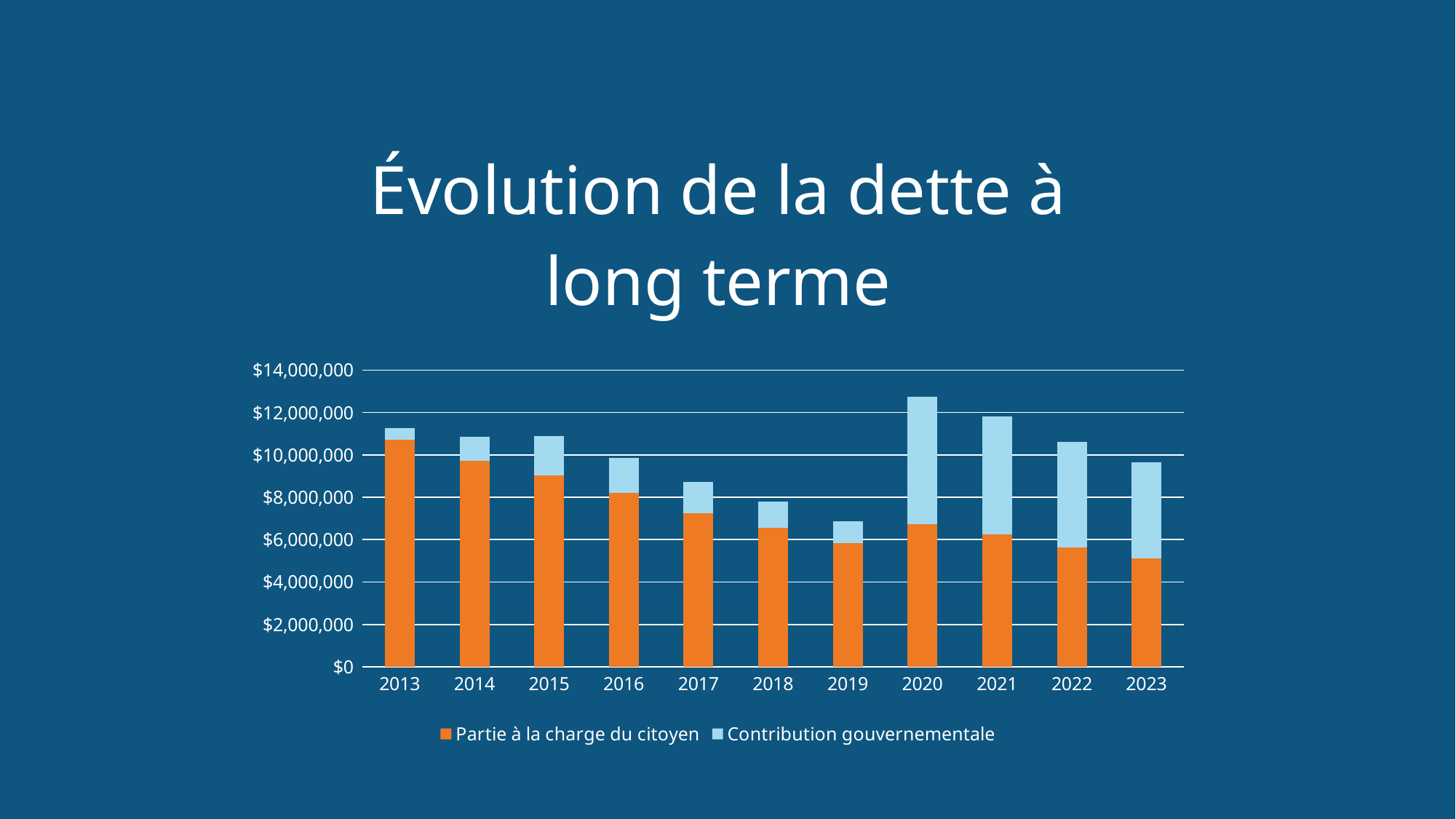
Is the 'Partie à la charge du citoyen' value for 2013 greater or less than $10,000,000? greater Which year has the lowest total bar in the chart? 2019 How many years are shown on the x axis of the chart? 11 Does the 'Partie à la charge du citoyen' segment rise or fall from 2013 to 2019? Fall Which year has the highest total bar in the chart? 2020 Is the 'Partie à la charge du citoyen' value for 2023 greater or less than $6,000,000? less Which total bar is taller, 2013 or 2020? 2020 Is the total bar for 2020 greater or less than $12,000,000? greater How many series does the chart legend list? 2 What kind of chart is shown on the slide? Stacked bar chart Which year has the largest 'Partie à la charge du citoyen' segment? 2013